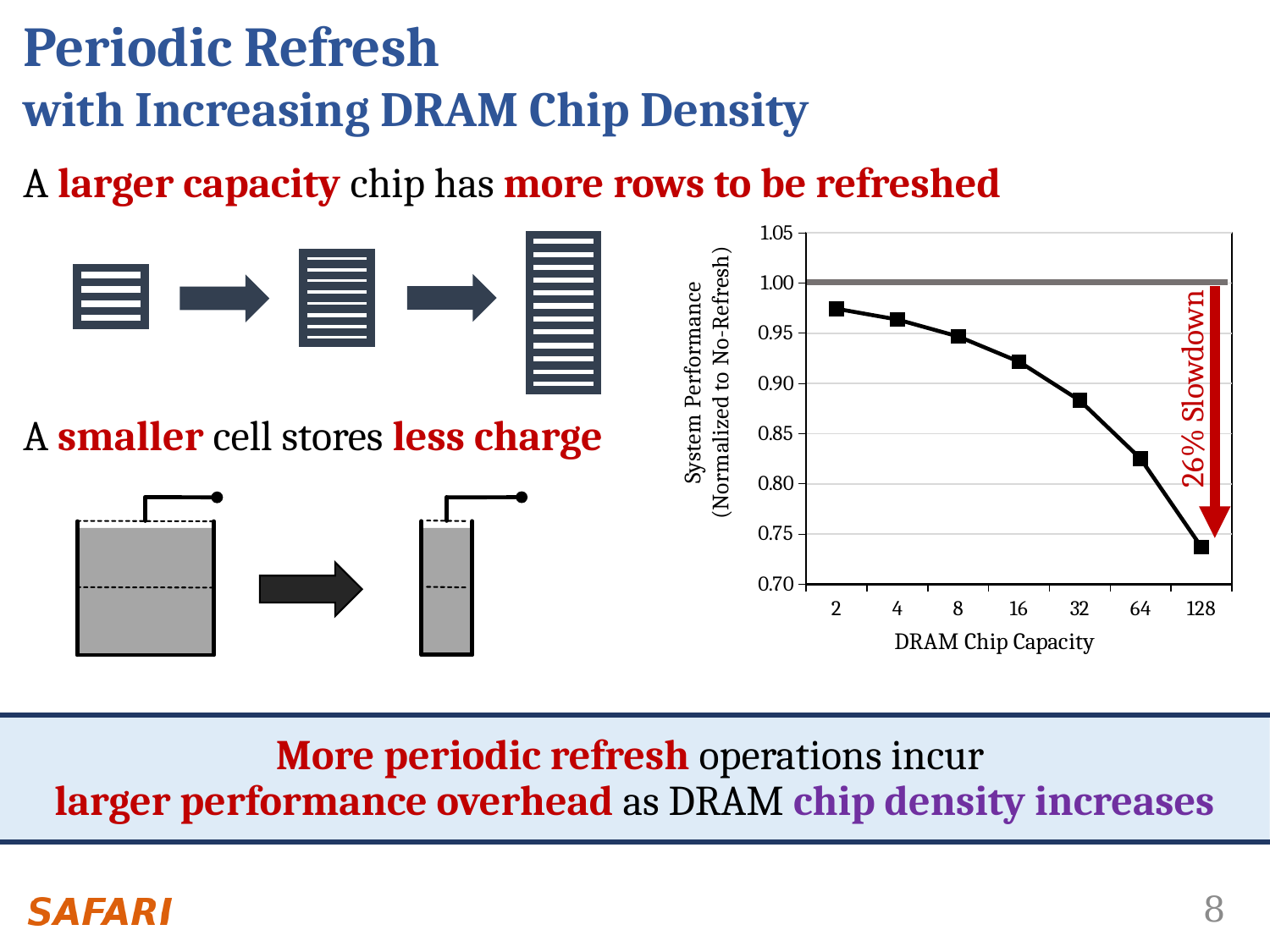
Which DRAM chip capacity has the lowest system performance? 128 Which has higher system performance: a DRAM chip capacity of 8 or 64? 8 Is the system performance for a DRAM chip capacity of 64 greater or less than 0.80? greater Is the system performance for a DRAM chip capacity of 128 greater or less than 0.75? less What slowdown percentage is annotated by the red arrow on the chart? 26% Slowdown Is the system performance for a DRAM chip capacity of 32 greater or less than 0.90? less How many DRAM chip capacity points are plotted on the chart? 7 What kind of chart is shown on the slide? line chart Which DRAM chip capacity has the highest system performance? 2 Does system performance rise or fall as DRAM chip capacity increases along the x axis? fall What is the label of the x axis of the chart? DRAM Chip Capacity